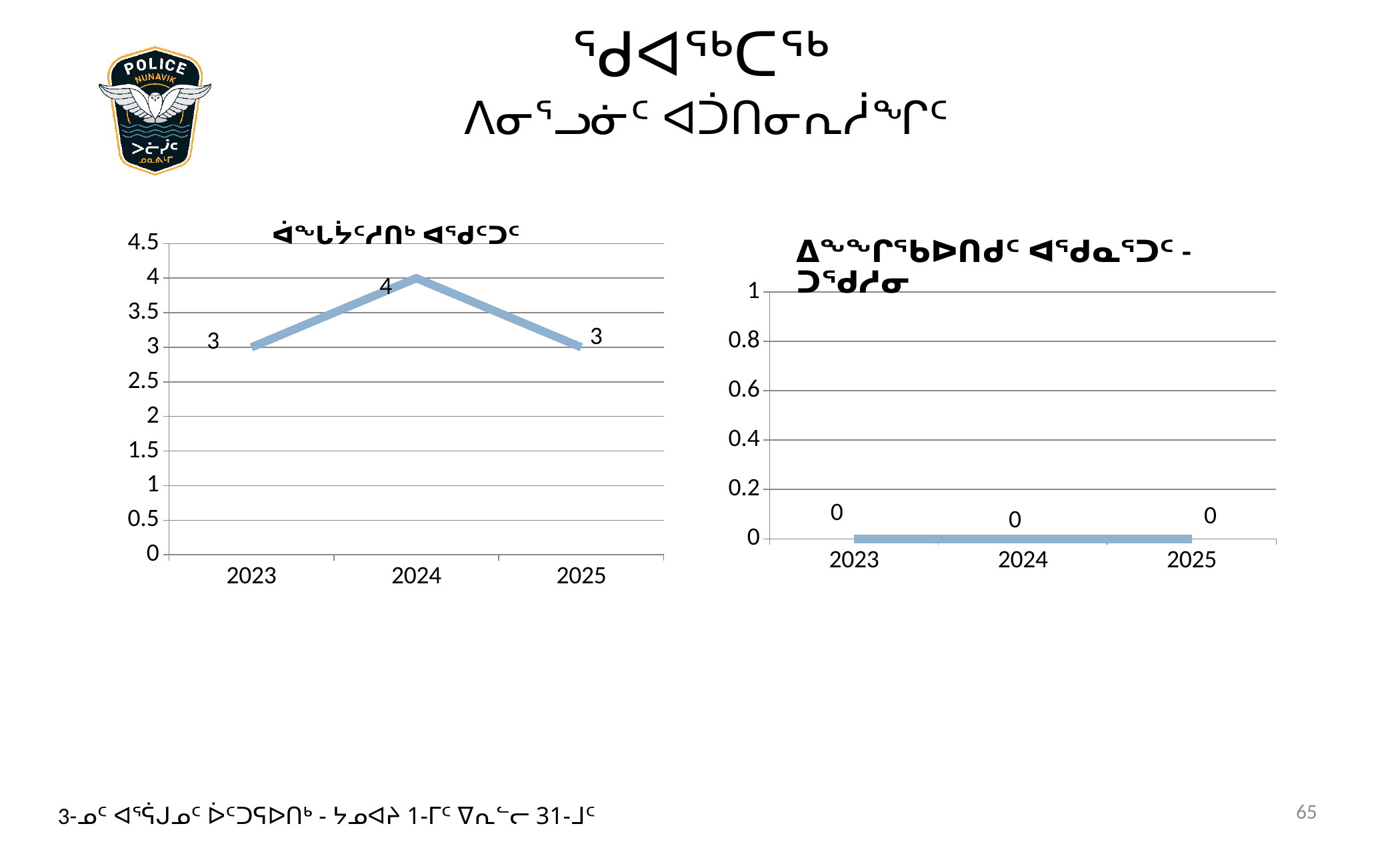
On the left chart, what is the difference between the values for 2024 and 2023? 1 On the right chart, what is the value for 2024? 0 On the left chart, how many years are plotted on the x axis? 3 What kind of chart is the left chart? line chart On the right chart, what is the value for 2025? 0 On the right chart, what is the highest value shown on the y axis? 1 On the left chart, what is the value for 2023? 3 On the left chart, what is the value for 2024? 4 On the left chart, which is larger, the value for 2024 or the value for 2025? 2024 On the left chart, which year has the highest value? 2024 On the left chart, what is the value for 2025? 3 On the left chart, does the value rise or fall from 2024 to 2025? fall